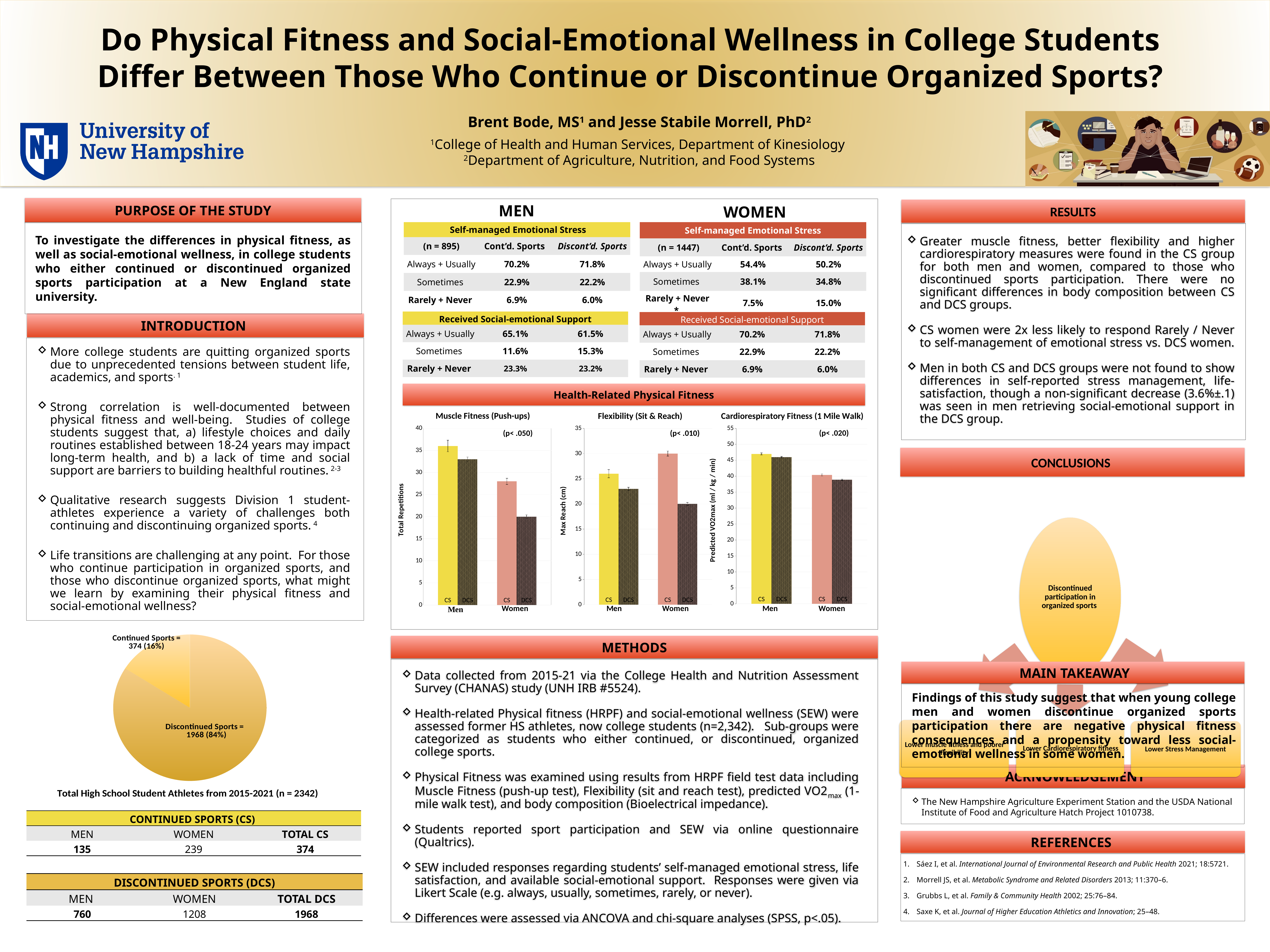
In the 'Cardiorespiratory Fitness (1 Mile Walk)' chart, is the value for Women CS greater or less than 45? less In the pie chart titled 'Total High School Student Athletes from 2015-2021', how many slices are there? 2 In the pie chart titled 'Total High School Student Athletes from 2015-2021', what value is shown for Continued Sports? 374 (16%) In the 'Muscle Fitness (Push-ups)' chart, is the value for Women DCS greater or less than 25? less What kind of chart is the 'Total High School Student Athletes from 2015-2021' chart? Pie chart In the 'Muscle Fitness (Push-ups)' chart, which bar is the lowest? Women DCS What kind of chart is the 'Muscle Fitness (Push-ups)' chart? Bar chart In the pie chart titled 'Total High School Student Athletes from 2015-2021', what value is shown for Discontinued Sports? 1968 (84%) In the 'Flexibility (Sit & Reach)' chart, is the value for Women CS greater or less than 25? greater In the pie chart titled 'Total High School Student Athletes from 2015-2021', what share of the pie does the Discontinued Sports slice represent? 84% In the 'Muscle Fitness (Push-ups)' chart, which bar is the highest? Men CS In the 'Flexibility (Sit & Reach)' chart, which bar is the highest? Women CS